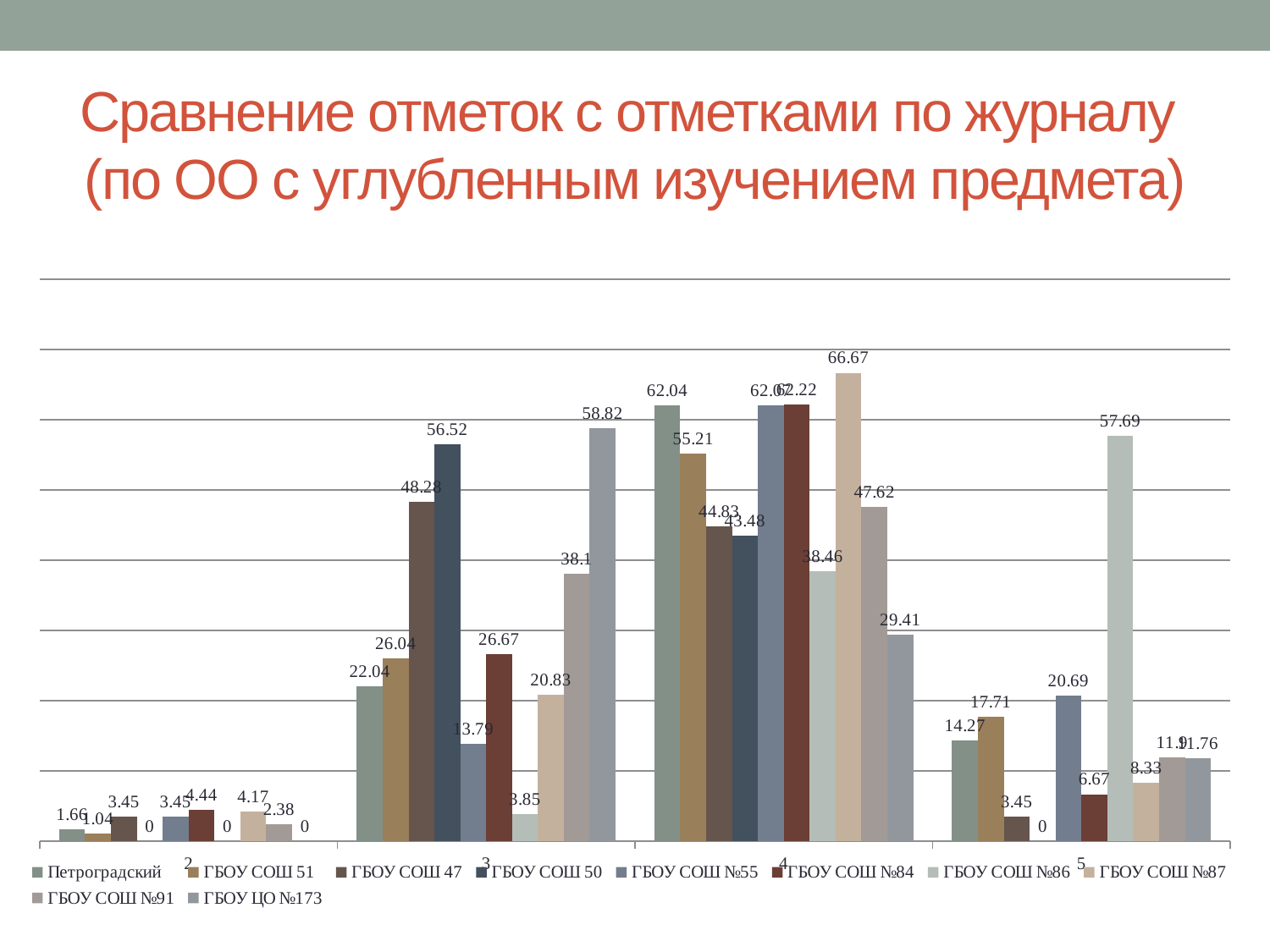
In category 3, which is larger: ГБОУ СОШ 47 or ГБОУ СОШ №91? ГБОУ СОШ 47 How many categories are shown along the x axis? 4 Which series has the highest value in category 4? ГБОУ СОШ №87 What is the value for ГБОУ СОШ №87 in category 4? 66.67 What is the value for ГБОУ СОШ №86 in category 5? 57.69 What is the difference between the Петроградский values in category 4 and category 3? 40 Which series has the highest value in category 3? ГБОУ ЦО №173 What is the value for ГБОУ СОШ 50 in category 3? 56.52 What is the first entry in the chart legend? Петроградский How many series does the legend list? 10 What kind of chart is shown on the slide? bar chart Which series has the highest value in category 5? ГБОУ СОШ №86